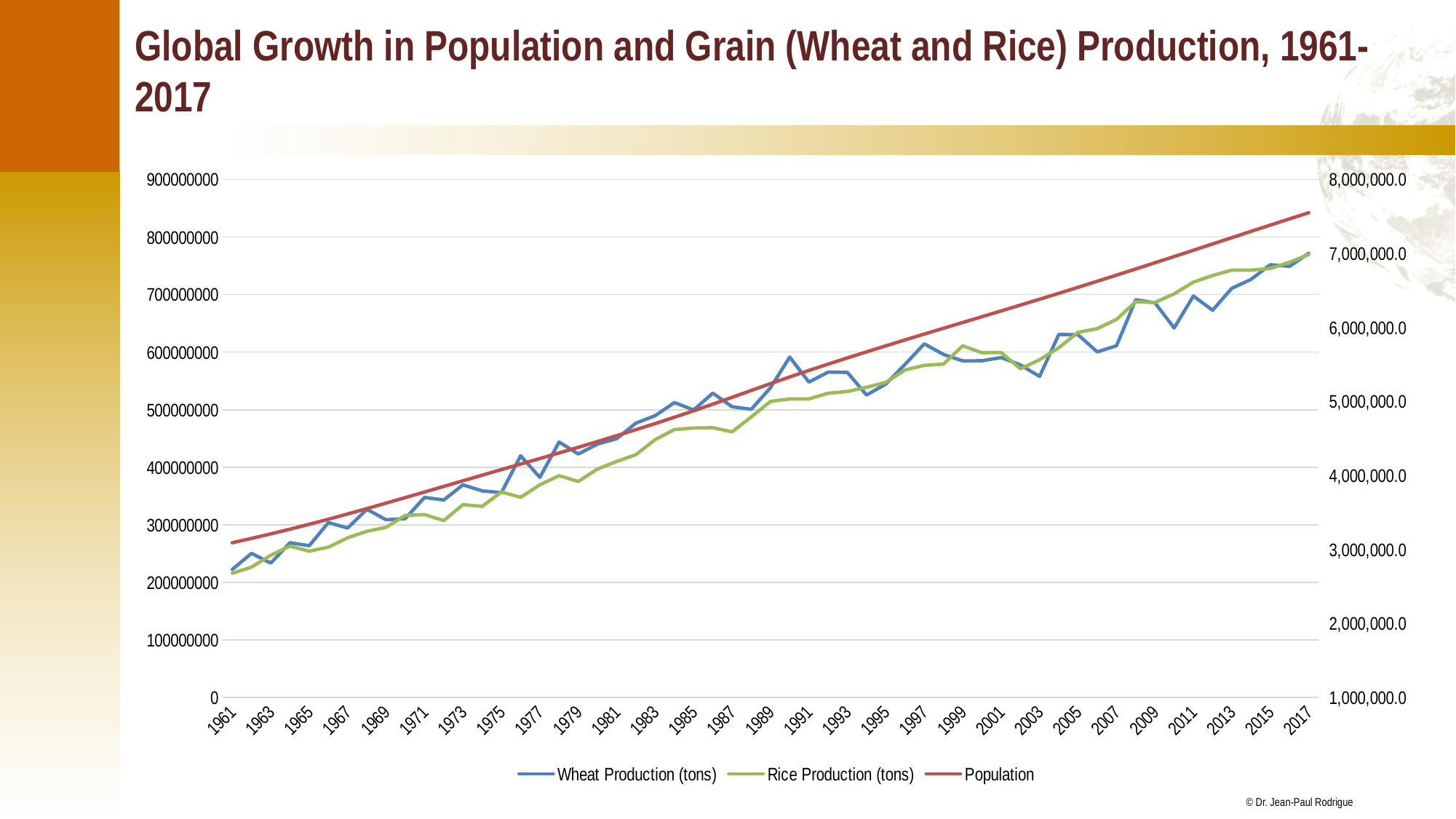
Is the value for Rice Production (tons) in 2017 greater or less than 700000000? greater What is the highest value shown on the right-hand axis? 8,000,000.0 Does the Population line rise or fall from 1961 to 2017? rise Is the value for Rice Production (tons) in 1975 greater or less than 400000000? less How many series does the legend list? 3 What kind of chart is shown on the slide? line chart How many years are covered on the x axis, from 1961 to 2017 inclusive? 57 What are the three series named in the legend? Wheat Production (tons), Rice Production (tons), Population Overall, does Wheat Production (tons) rise or fall across the years shown? rise In 2011, which is larger: Wheat Production (tons) or Rice Production (tons)? Rice Production (tons) Is the value for Wheat Production (tons) in 1961 greater or less than 300000000? less